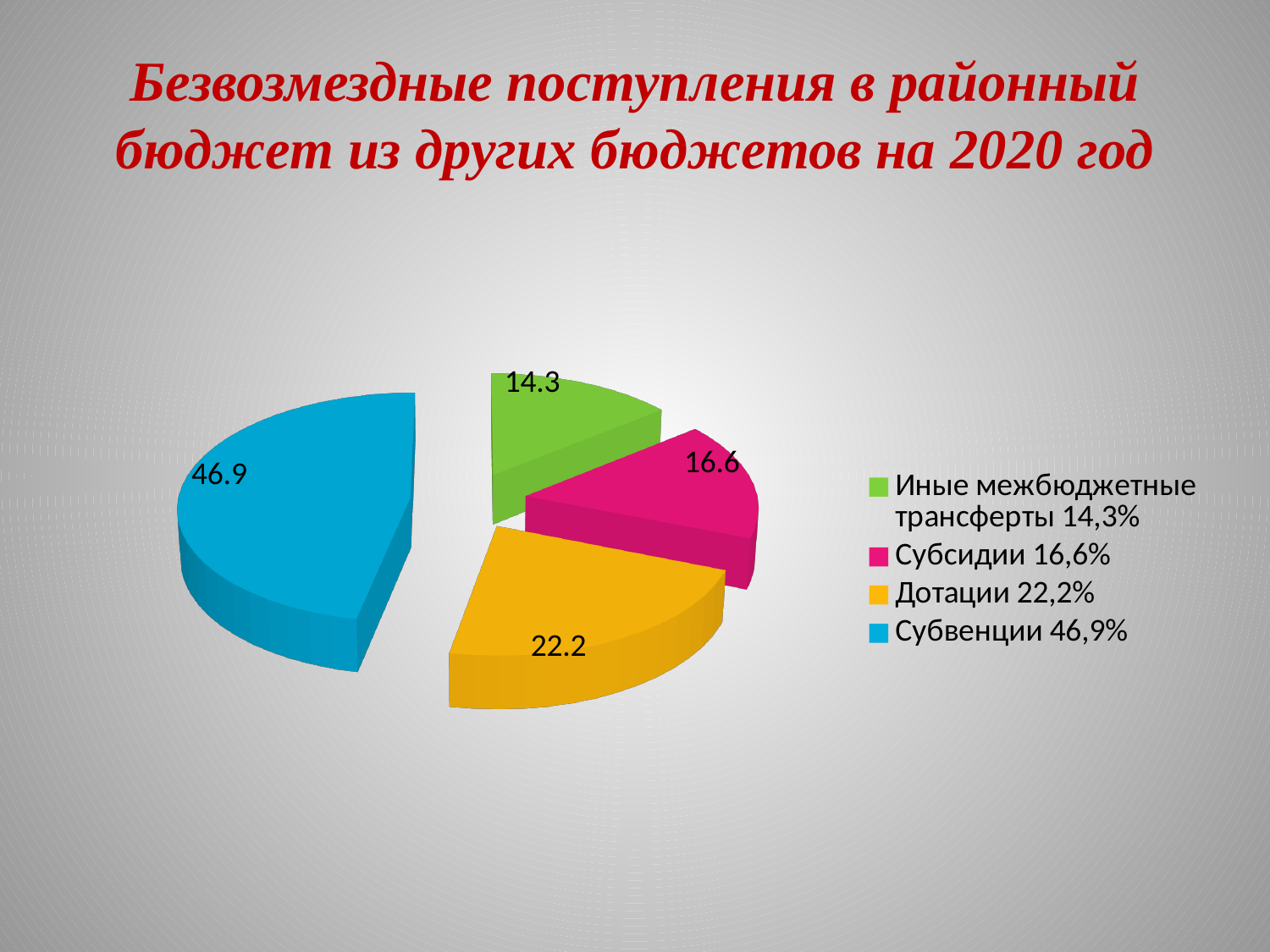
What is the data label on the slice for Субсидии? 16.6 What is the data label on the slice for Иные межбюджетные трансферты? 14.3 Which category has the largest slice of the pie? Субвенции What kind of chart is shown on the slide? pie chart What is the data label on the slice for Дотации? 22.2 Which category has the smallest slice of the pie? Иные межбюджетные трансферты What is the difference between the values for Субвенции and Дотации? 24.7 Which is larger, the value for Субсидии or the value for Дотации? Дотации What share of the pie does Субвенции represent according to the legend? 46,9% What colour is the slice for Дотации? yellow How many slices does the pie chart have? 4 What is the data label on the slice for Субвенции? 46.9